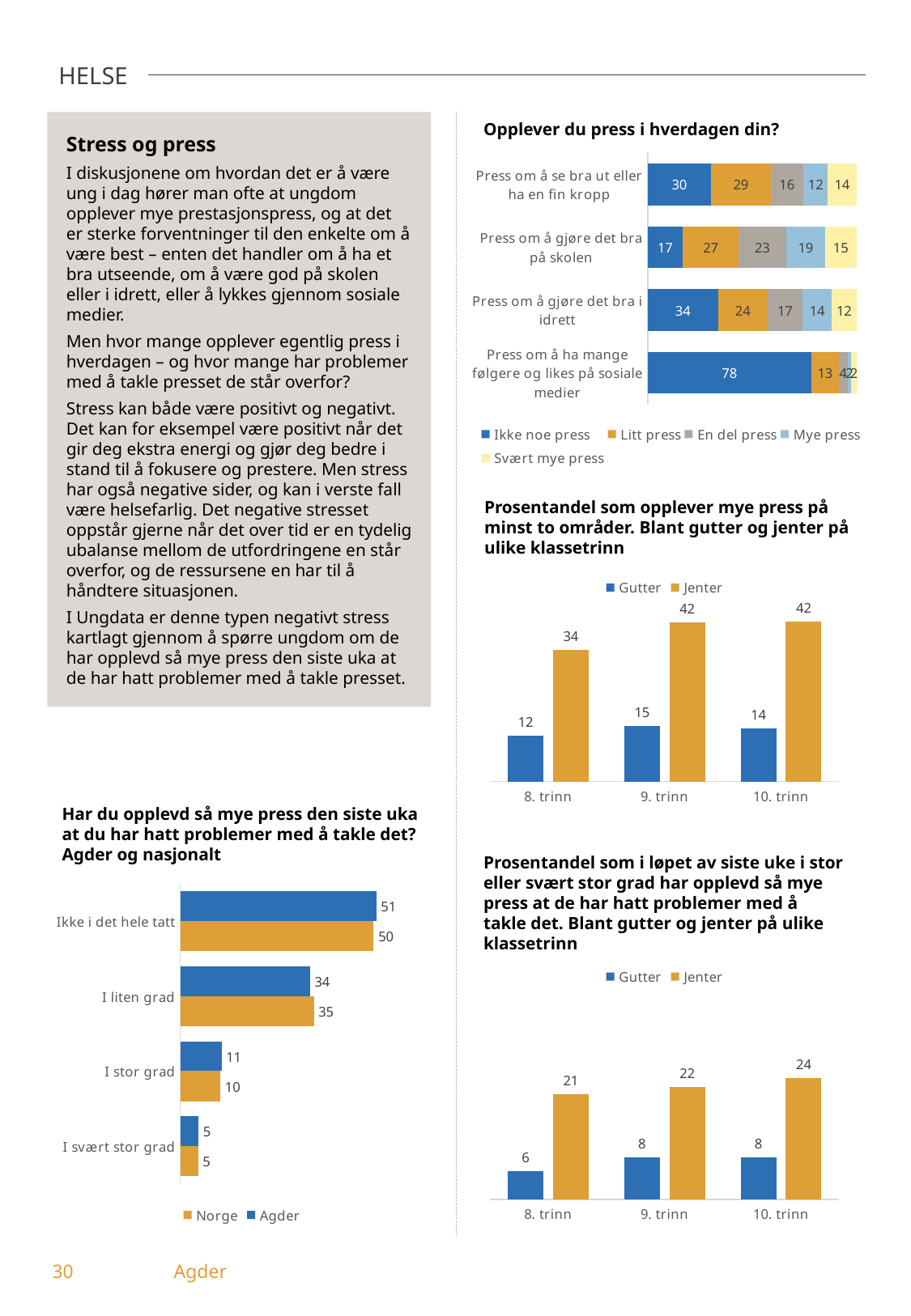
In the chart 'Prosentandel som i løpet av siste uke i stor eller svært stor grad har opplevd så mye press', do the Jenter values rise or fall from 8. trinn to 10. trinn? rise In the chart 'Prosentandel som opplever mye press på minst to områder', what is the value for Jenter in 9. trinn? 42 In the chart 'Prosentandel som opplever mye press på minst to områder', what is the difference between Jenter and Gutter in 8. trinn? 22 In the chart 'Har du opplevd så mye press den siste uka at du har hatt problemer med å takle det? Agder og nasjonalt', how many categories are shown? 4 In the chart 'Har du opplevd så mye press den siste uka at du har hatt problemer med å takle det? Agder og nasjonalt', which is larger for 'I stor grad', Norge or Agder? Agder In the chart 'Prosentandel som opplever mye press på minst to områder', which group has the lowest value for Gutter? 8. trinn In the chart 'Opplever du press i hverdagen din?', which category has the highest value for 'Ikke noe press'? Press om å ha mange følgere og likes på sosiale medier In the chart 'Opplever du press i hverdagen din?', what is the value for 'Litt press' for 'Press om å gjøre det bra på skolen'? 27 In the chart 'Opplever du press i hverdagen din?', how many series does the legend list? 5 In the chart 'Har du opplevd så mye press den siste uka at du har hatt problemer med å takle det? Agder og nasjonalt', what is the value for Agder for 'I liten grad'? 34 In the chart 'Opplever du press i hverdagen din?', what is the value for 'Ikke noe press' for 'Press om å ha mange følgere og likes på sosiale medier'? 78 In the chart 'Prosentandel som i løpet av siste uke i stor eller svært stor grad har opplevd så mye press', what is the value for Jenter in 10. trinn? 24